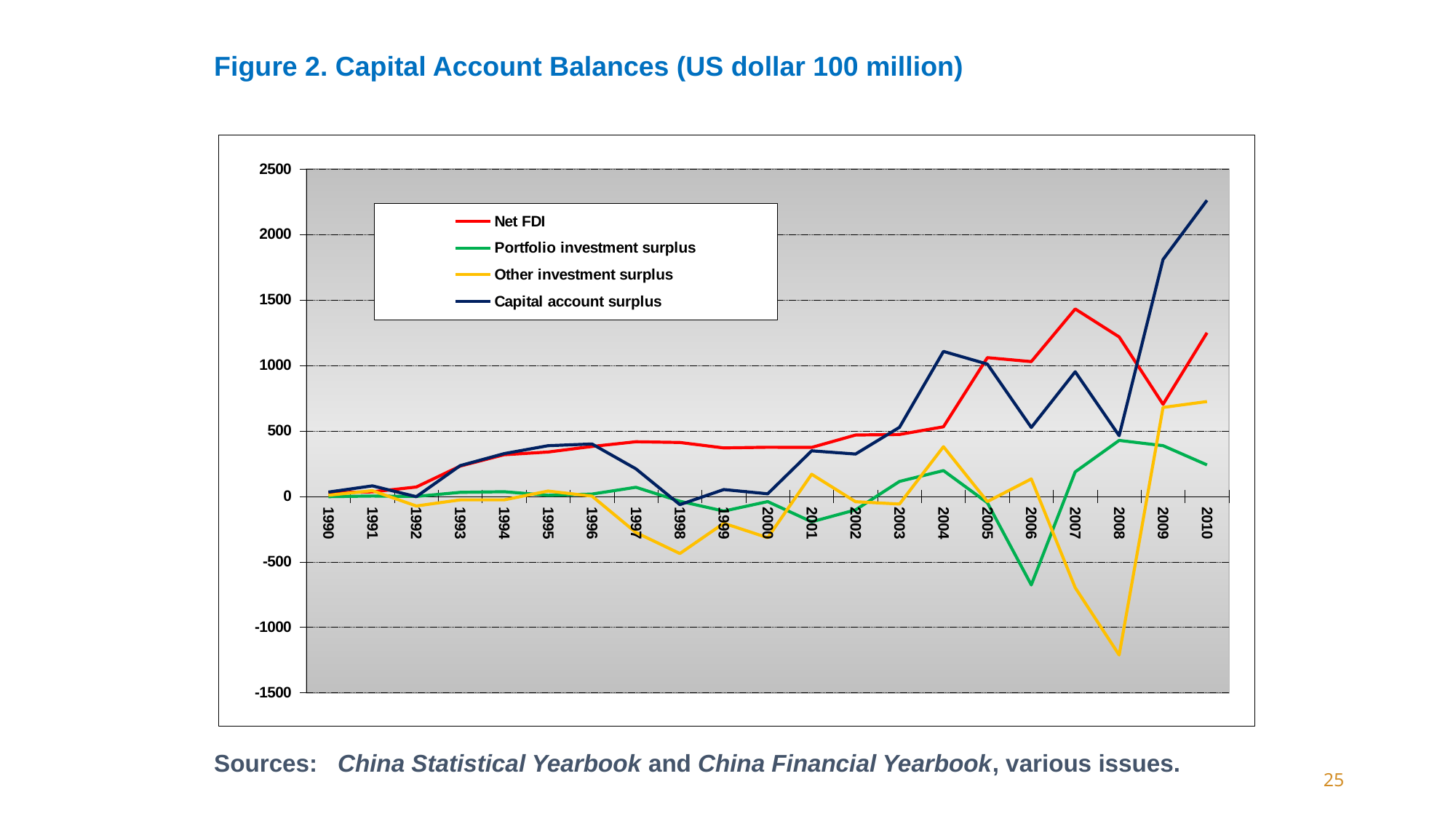
Is the value of Net FDI in 2007 greater or less than 1000? greater In which year does Other investment surplus reach its lowest value? 2008 In 2008, which is larger: Net FDI or Capital account surplus? Net FDI Is the value of Capital account surplus in 2010 greater or less than 2000? greater Which series has the lowest value in 2006? Portfolio investment surplus Is the value of Other investment surplus in 2008 greater or less than -1000? less In which year does Capital account surplus reach its highest value? 2010 How many years are plotted along the x axis? 21 How many series does the legend list? 4 Does Capital account surplus rise or fall from 2008 to 2010? Rise What kind of chart is shown on the slide? Line chart